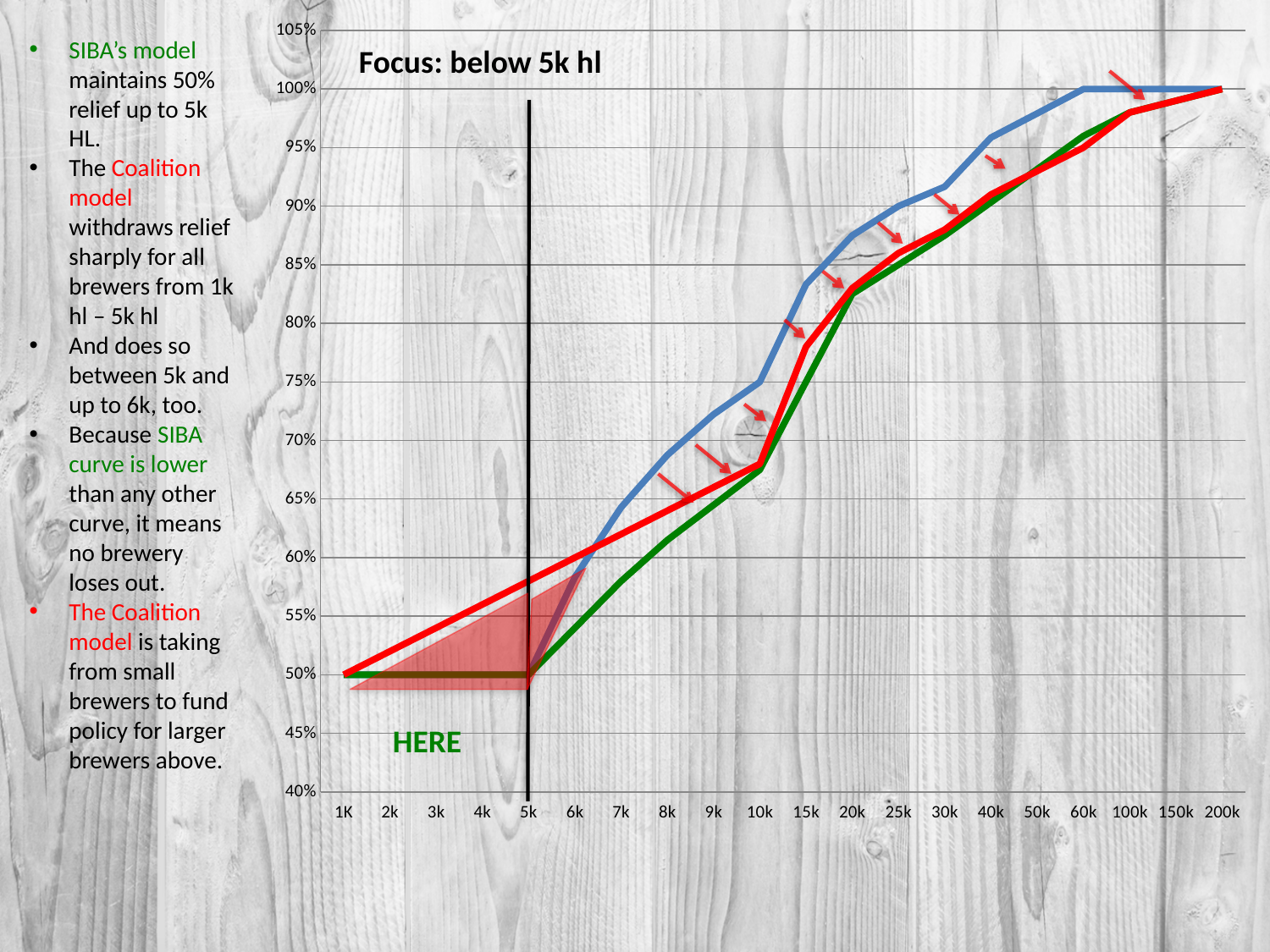
What value does the blue line reach at 60k? 100% What kind of chart is shown on the slide? line chart How many lines are plotted on the chart? 3 What value does the green line have at 1K? 50% Do the plotted values generally rise or fall as you move from 1K to 200k along the x axis? rise How many categories are labelled on the x axis of the chart? 20 What value does the green line have at 5k? 50% Is the value of the blue line at 10k greater or less than 70%? greater Is the value of the green line at 10k greater or less than 70%? less Is the value of the red line at 5k greater or less than 55%? greater What is the title shown on the chart? Focus: below 5k hl At 8k, which line has the higher value, the blue line or the green line? blue line